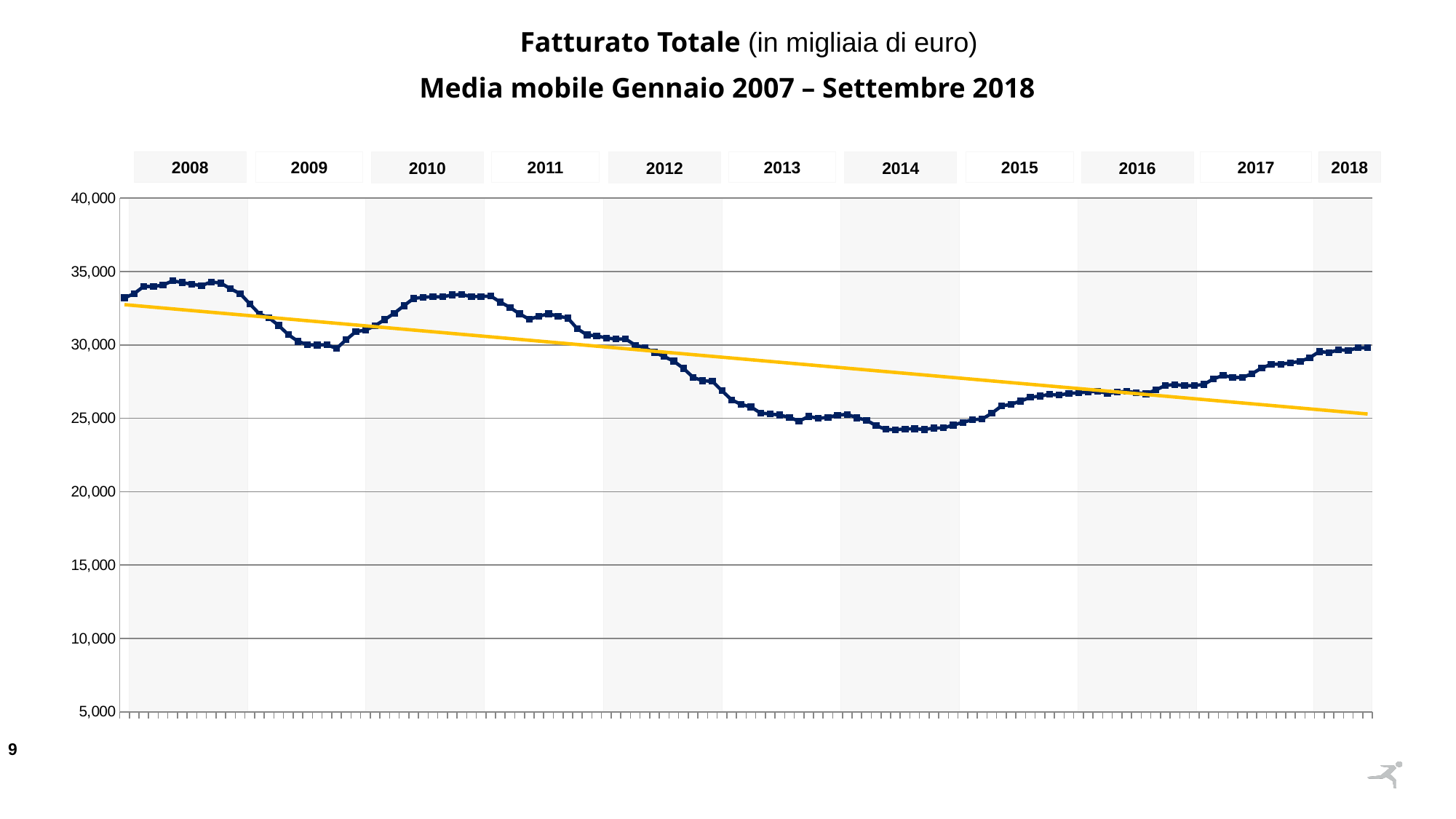
In which year does the moving average reach its highest point? 2008 How many year labels are shown above the chart? 11 Is the moving average value at the end of 2018 greater or less than 35,000? less In which year does the moving average reach its lowest point? 2014 Is the moving average value at the start of 2008 greater or less than 30,000? greater Overall, does the moving average line end higher or lower in 2018 than it started in 2007? lower What is the title of the chart? Fatturato Totale (in migliaia di euro) Media mobile Gennaio 2007 – Settembre 2018 What kind of chart is shown on the slide? line chart Does the yellow trend line rise or fall from left to right? fall Which is higher: the moving average in 2010 or in 2013? 2010 Is the moving average value in the middle of 2014 greater or less than 25,000? less What is the highest value shown on the vertical axis? 40,000